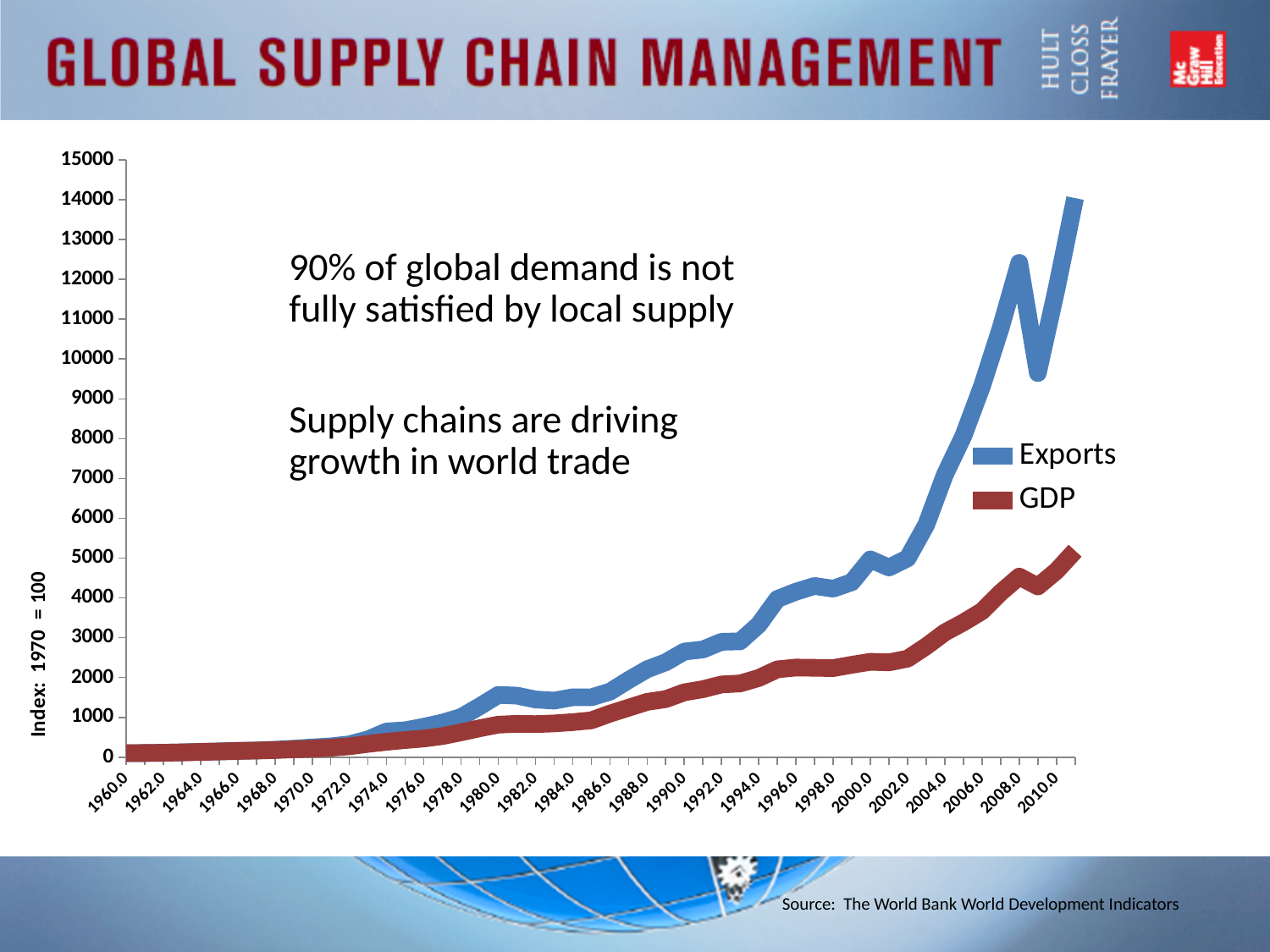
Is the value for GDP in 2000.0 greater or less than 3000? less Which series reaches the higher value by 2010.0, Exports or GDP? Exports What are the two series named in the legend? Exports and GDP How many series does the legend list? 2 Is the value for Exports in 2008.0 greater or less than 10000? greater What kind of chart is shown on the slide? line chart How many year labels are shown along the x axis? 26 Do the Exports values generally rise or fall from 1960.0 to 2010.0? rise Is the value for Exports in 2010.0 greater or less than 13000? less Which series reaches the highest value on the chart? Exports What is the label on the vertical axis? Index: 1970 = 100